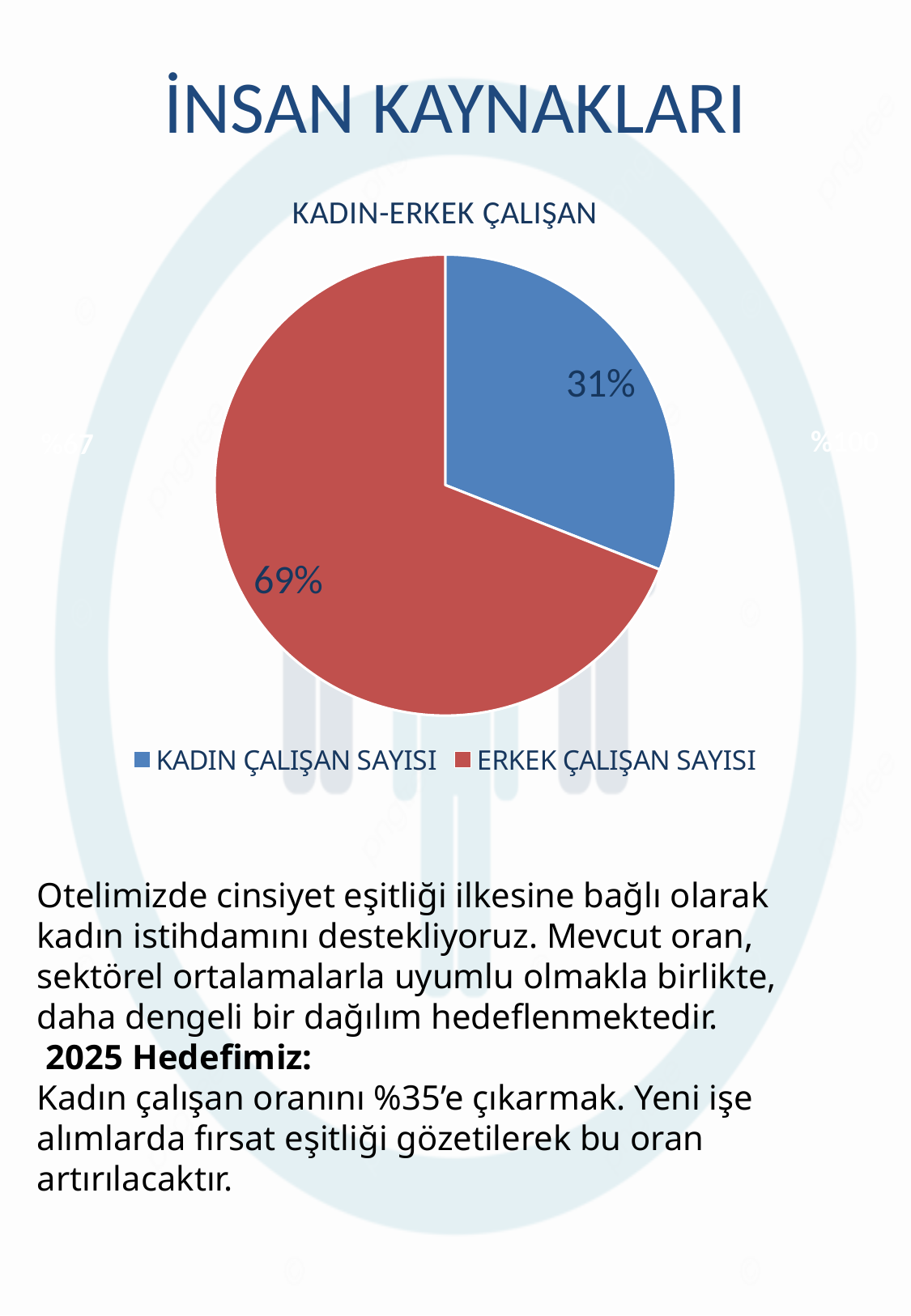
How many entries does the legend list? 2 What colour is the KADIN ÇALIŞAN SAYISI slice? blue What is the difference in percentage points between the ERKEK ÇALIŞAN SAYISI and KADIN ÇALIŞAN SAYISI slices? 38% What is the title of the chart? KADIN-ERKEK ÇALIŞAN Which slice is the smallest in the pie chart? KADIN ÇALIŞAN SAYISI Which is larger, the KADIN ÇALIŞAN SAYISI slice or the ERKEK ÇALIŞAN SAYISI slice? ERKEK ÇALIŞAN SAYISI What kind of chart is shown on the slide? pie chart What share of the pie does ERKEK ÇALIŞAN SAYISI represent? 69% Which slice is the largest in the pie chart? ERKEK ÇALIŞAN SAYISI What share of the pie does KADIN ÇALIŞAN SAYISI represent? 31% How many slices does the pie chart have? 2